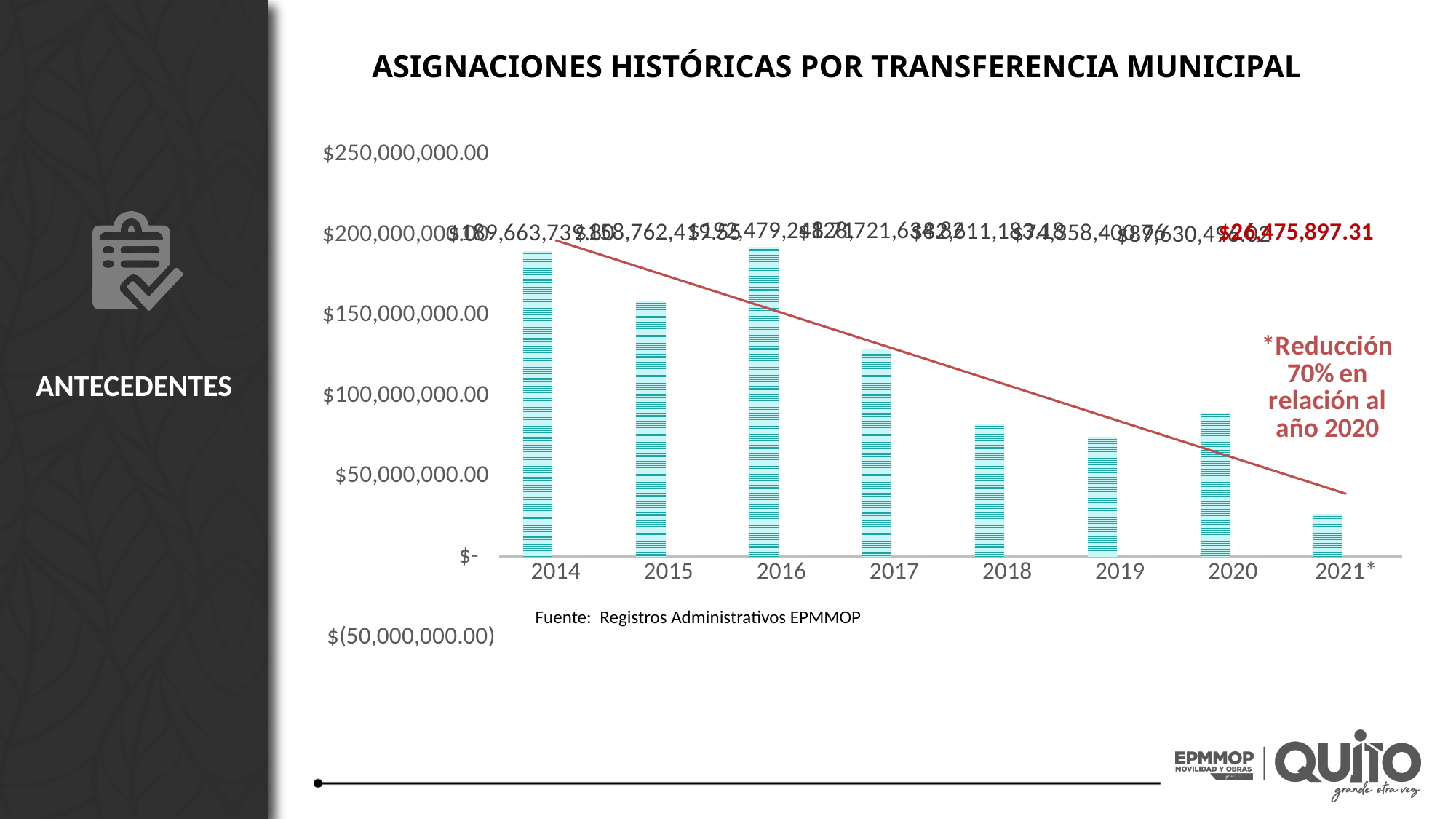
According to the red annotation, what percentage reduction does 2021* represent relative to 2020? 70% Is the value for 2014 greater or less than $150,000,000.00? greater Is the value for 2018 greater or less than $100,000,000.00? less What is the title of the chart? ASIGNACIONES HISTÓRICAS POR TRANSFERENCIA MUNICIPAL Which year has the lowest value in the chart? 2021* What is the value shown for 2021*? $26,475,897.31 How many years are shown on the x axis of the chart? 8 What kind of chart is shown on the slide? bar chart Do the values generally rise or fall from 2014 to 2021*? fall Is the value for 2017 greater or less than $100,000,000.00? greater Which is larger, the value for 2019 or the value for 2020? 2020